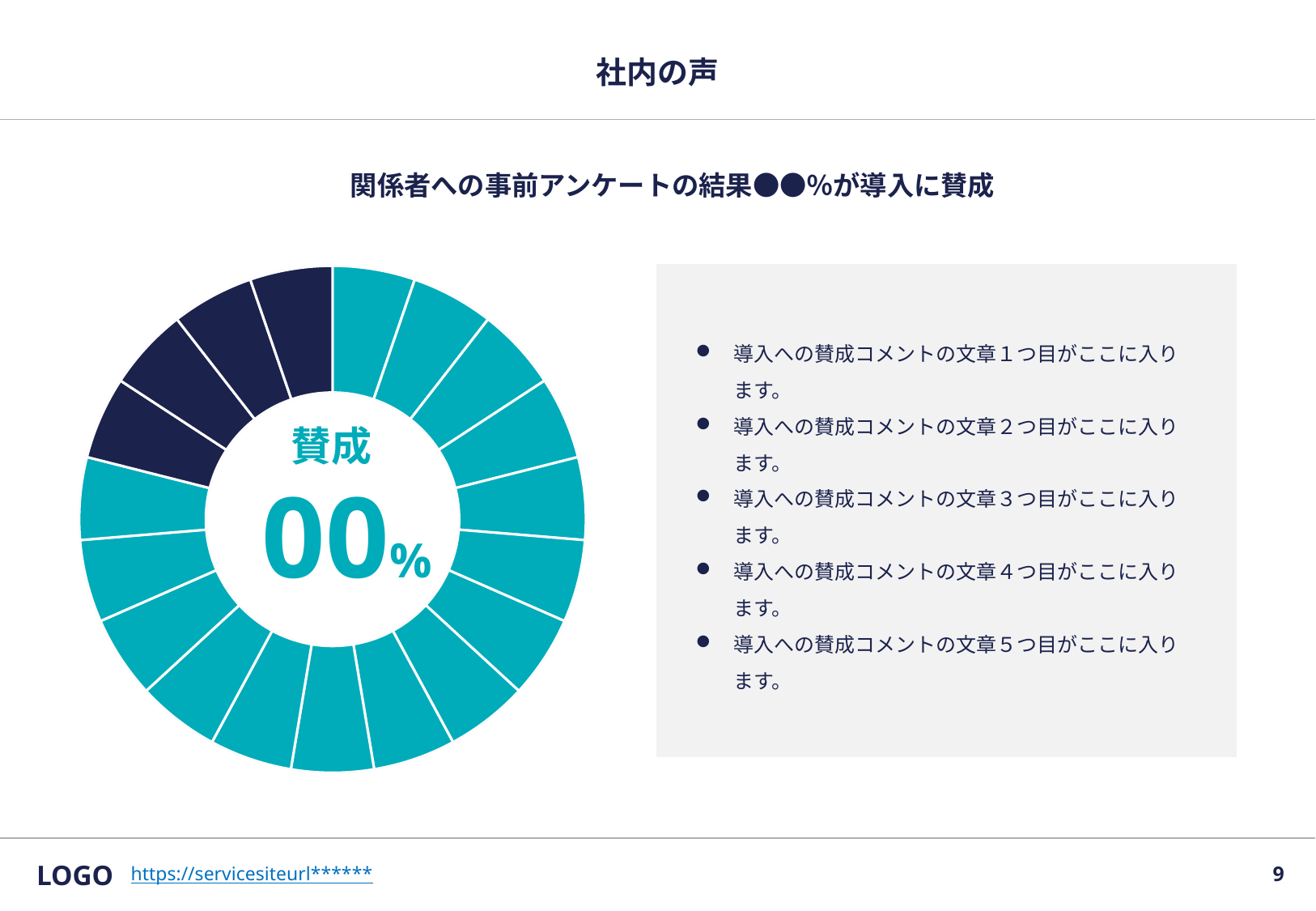
What label is printed in the centre of the donut chart? 賛成 How many dark navy segments are there in the donut chart? 4 Which colour occupies the larger share of the donut chart, teal or dark navy? teal Which colour occupies the smaller share of the donut chart? dark navy What kind of chart is shown on the slide? pie chart (donut) What percentage value is printed in the centre of the donut chart? 00% What colour are the 賛成 segments of the donut chart? teal Is the teal (賛成) portion of the donut chart greater or less than half of the chart? greater Is the dark navy portion of the donut chart greater or less than half of the chart? less